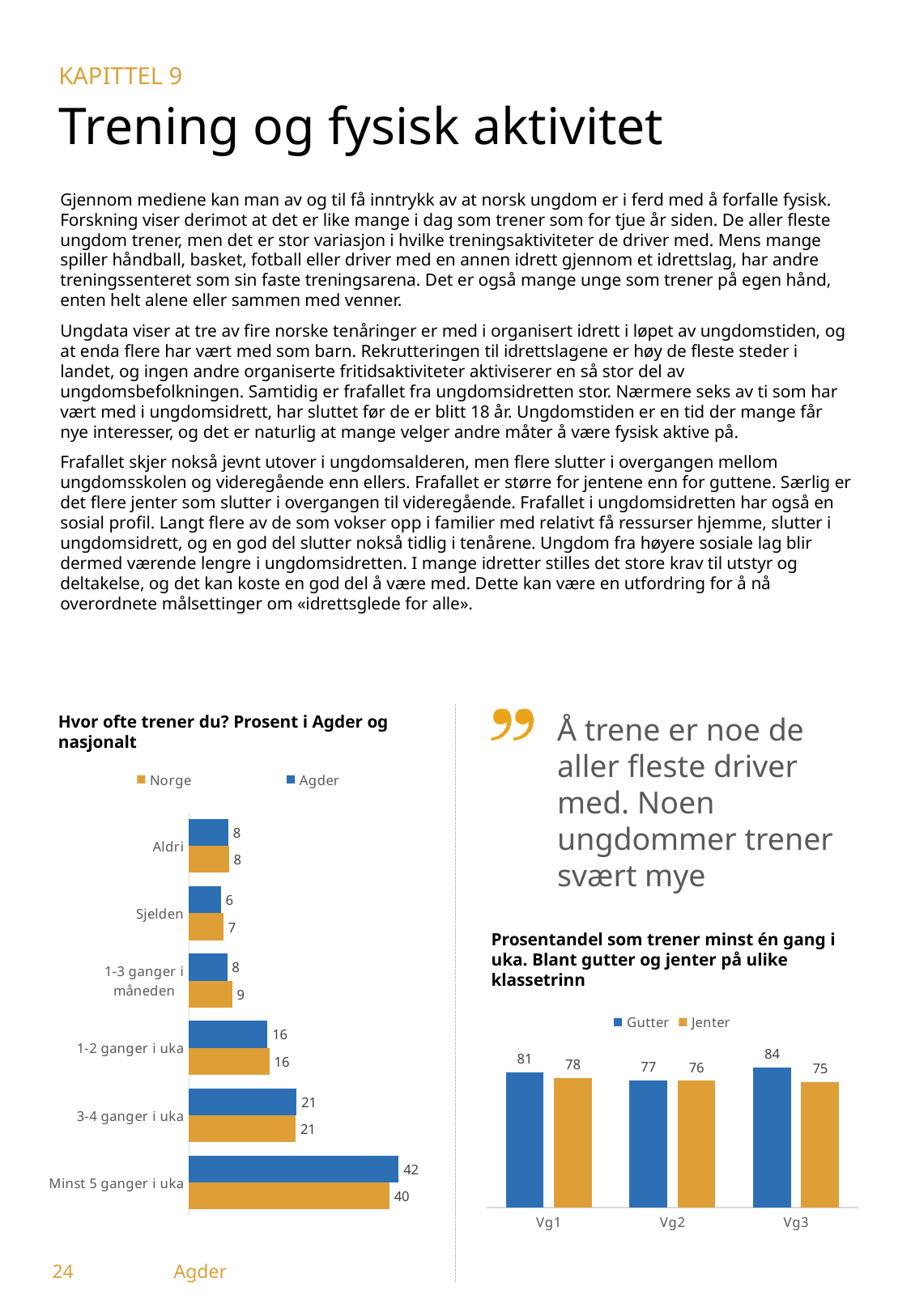
In the chart 'Hvor ofte trener du? Prosent i Agder og nasjonalt', what is the difference between the Agder and Norge values for 'Minst 5 ganger i uka'? 2 In the chart 'Hvor ofte trener du? Prosent i Agder og nasjonalt', which category has the highest value for Norge? Minst 5 ganger i uka In the chart 'Hvor ofte trener du? Prosent i Agder og nasjonalt', how many categories are shown? 6 In the chart 'Prosentandel som trener minst én gang i uka', which is larger at Vg2, Gutter or Jenter? Gutter In the chart 'Hvor ofte trener du? Prosent i Agder og nasjonalt', what is the value for Norge in the category 'Sjelden'? 7 In the chart 'Hvor ofte trener du? Prosent i Agder og nasjonalt', which category has the lowest value for Agder? Sjelden In the chart 'Prosentandel som trener minst én gang i uka', what is the value for Jenter at Vg1? 78 In the chart 'Prosentandel som trener minst én gang i uka', what is the value for Gutter at Vg3? 84 In the chart 'Prosentandel som trener minst én gang i uka', what is the difference between Gutter and Jenter at Vg3? 9 In the chart 'Hvor ofte trener du? Prosent i Agder og nasjonalt', how many series does the legend list? 2 In the chart 'Hvor ofte trener du? Prosent i Agder og nasjonalt', what is the value for Agder in the category 'Minst 5 ganger i uka'? 42 What kind of chart is 'Hvor ofte trener du? Prosent i Agder og nasjonalt'? Bar chart